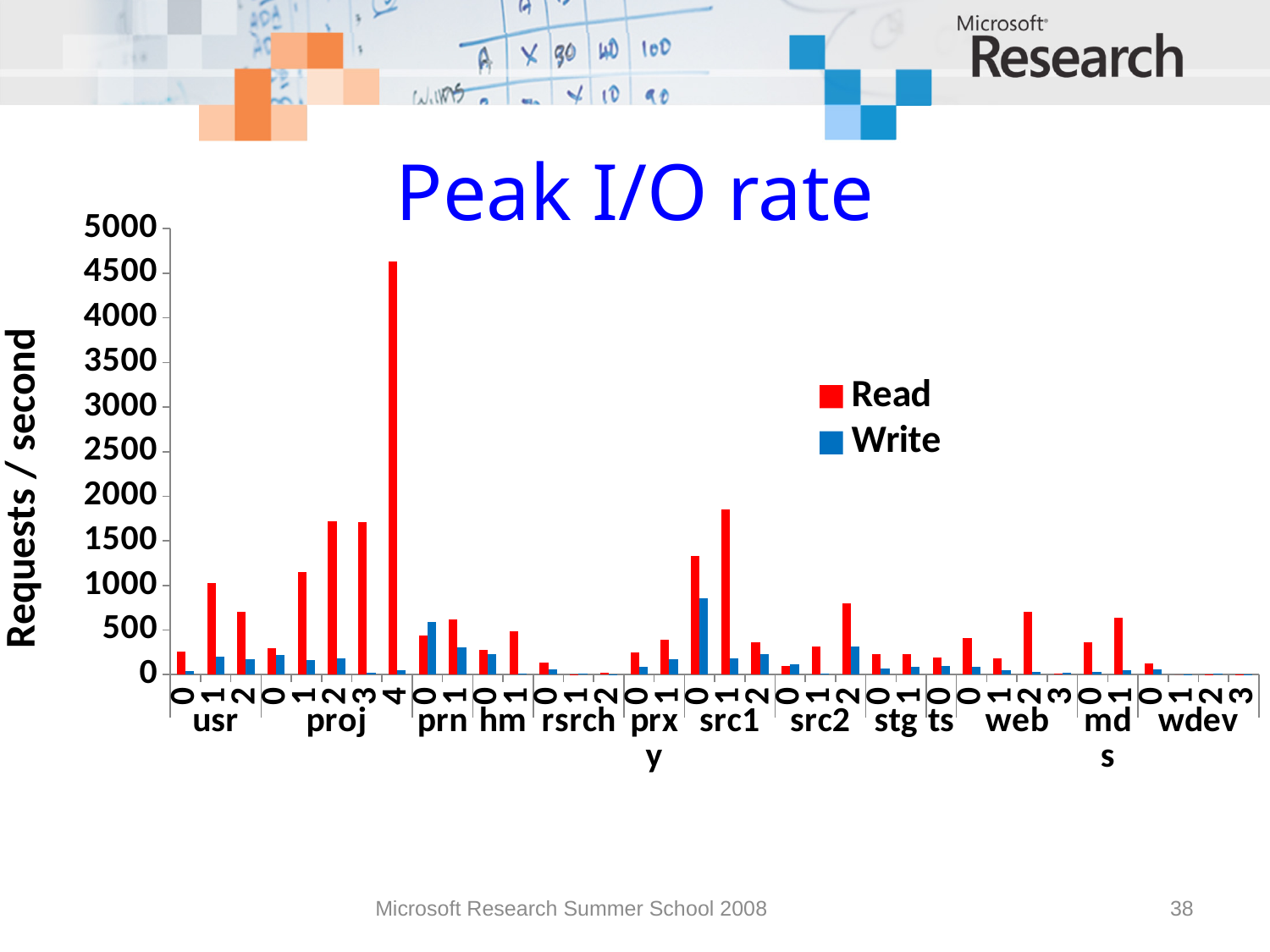
For prn 0, which is larger, the Read value or the Write value? Write Which has the larger Read value, src1 1 or src2 2? src1 1 How many series does the legend list? 2 Is the Read value for src1 1 greater or less than 1500? greater Which volume has the highest Read peak I/O rate? proj 4 Which series are listed in the legend? Read and Write Is the Write value for src1 0 greater or less than 500? greater What kind of chart is shown on the slide? bar chart Is the Read value for src2 2 greater or less than 1000? less What is the label of the vertical axis? Requests / second